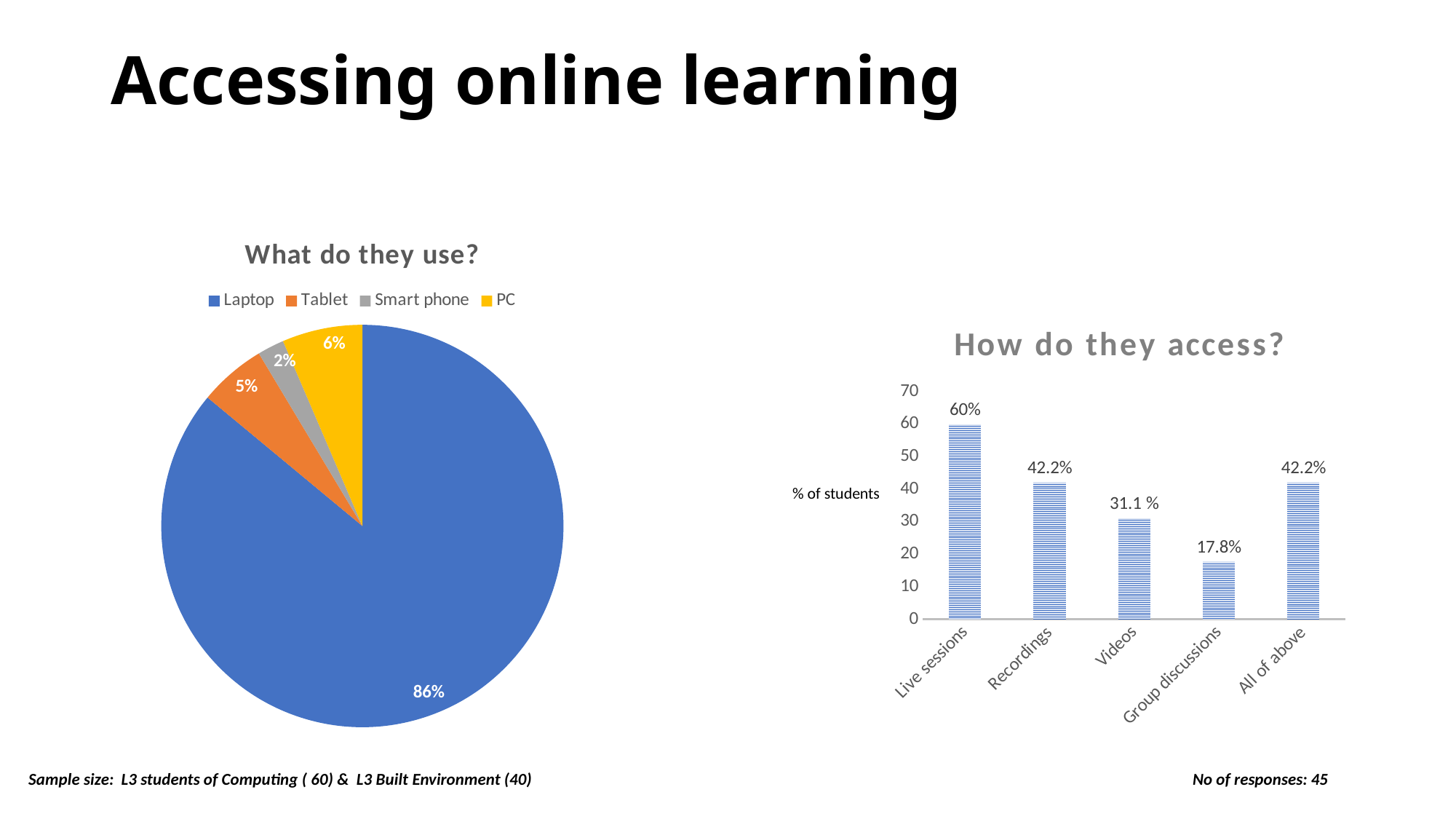
In the 'What do they use?' chart, what percentage is shown for Tablet? 5% In the 'How do they access?' chart, which category has the highest value? Live sessions In the 'What do they use?' chart, which is larger, PC or Tablet? PC What kind of chart is 'How do they access?'? Bar chart In the 'How do they access?' chart, what is the value for Group discussions? 17.8% In the 'How do they access?' chart, what is the value for Live sessions? 60% In the 'How do they access?' chart, what is the difference between Live sessions and Videos? 28.9% In the 'How do they access?' chart, how many categories are shown on the x axis? 5 In the 'What do they use?' chart, how many categories does the legend list? 4 What kind of chart is 'What do they use?'? Pie chart In the 'What do they use?' chart, what share of the pie is Laptop? 86% In the 'What do they use?' chart, which category has the smallest slice? Smart phone